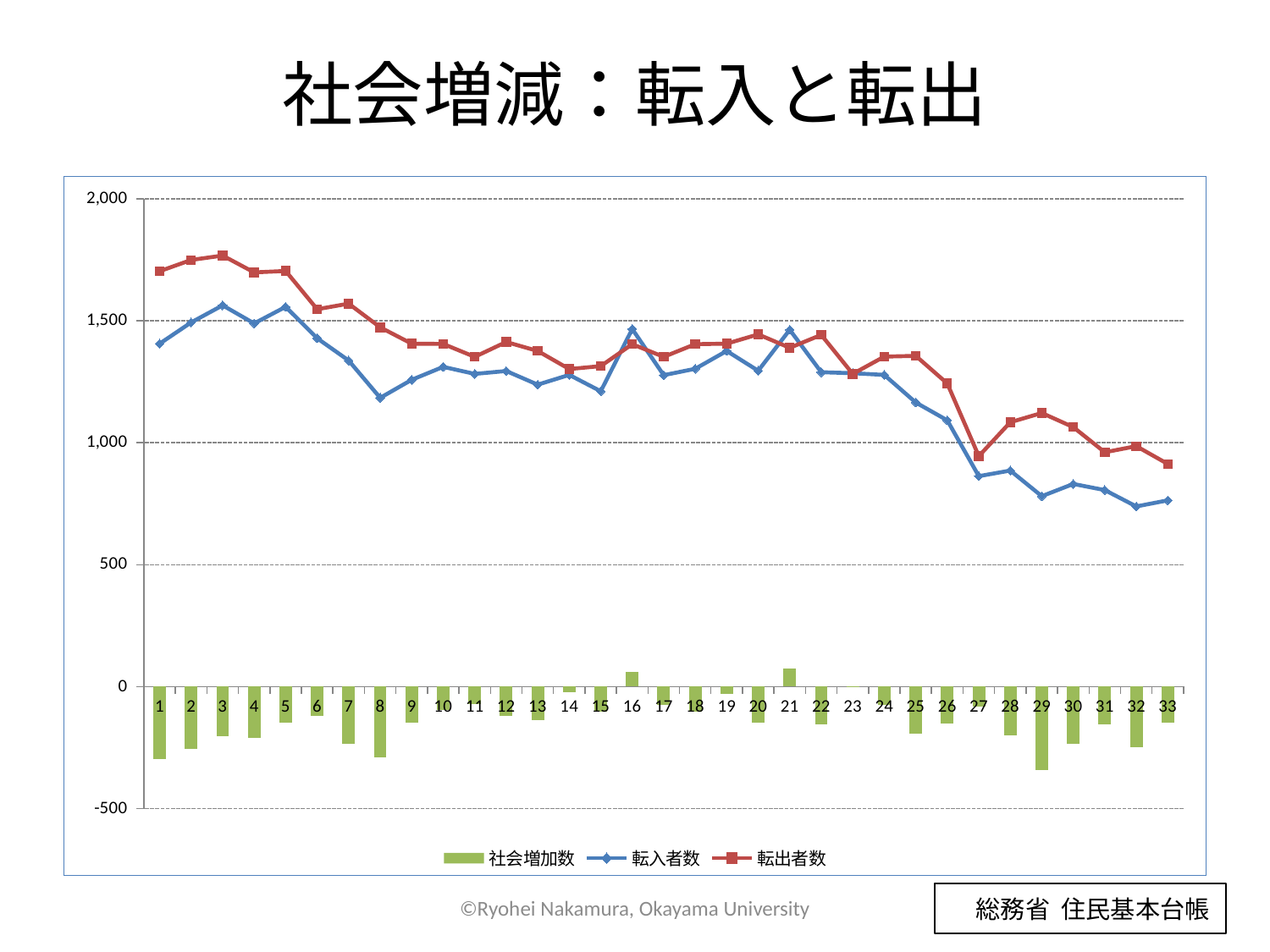
Is the value of 転入者数 at point 1 greater or less than 1,500? less At which point is the 社会増加数 bar the most negative (lowest)? 29 What kind of chart is this? A combined bar and line chart Is the value of 転出者数 at point 1 greater or less than 1,500? greater Is the value of 転入者数 at point 33 greater or less than 1,000? less What are the three series named in the legend? 社会増加数, 転入者数, 転出者数 Does the 転出者数 line generally rise or fall from point 1 to point 33? Fall At point 1, which is larger: 転入者数 or 転出者数? 転出者数 At which point does the 転出者数 line reach its highest value? 3 How many series does the legend list? 3 How many points are there along the x axis? 33 At point 21, which is larger: 転入者数 or 転出者数? 転入者数